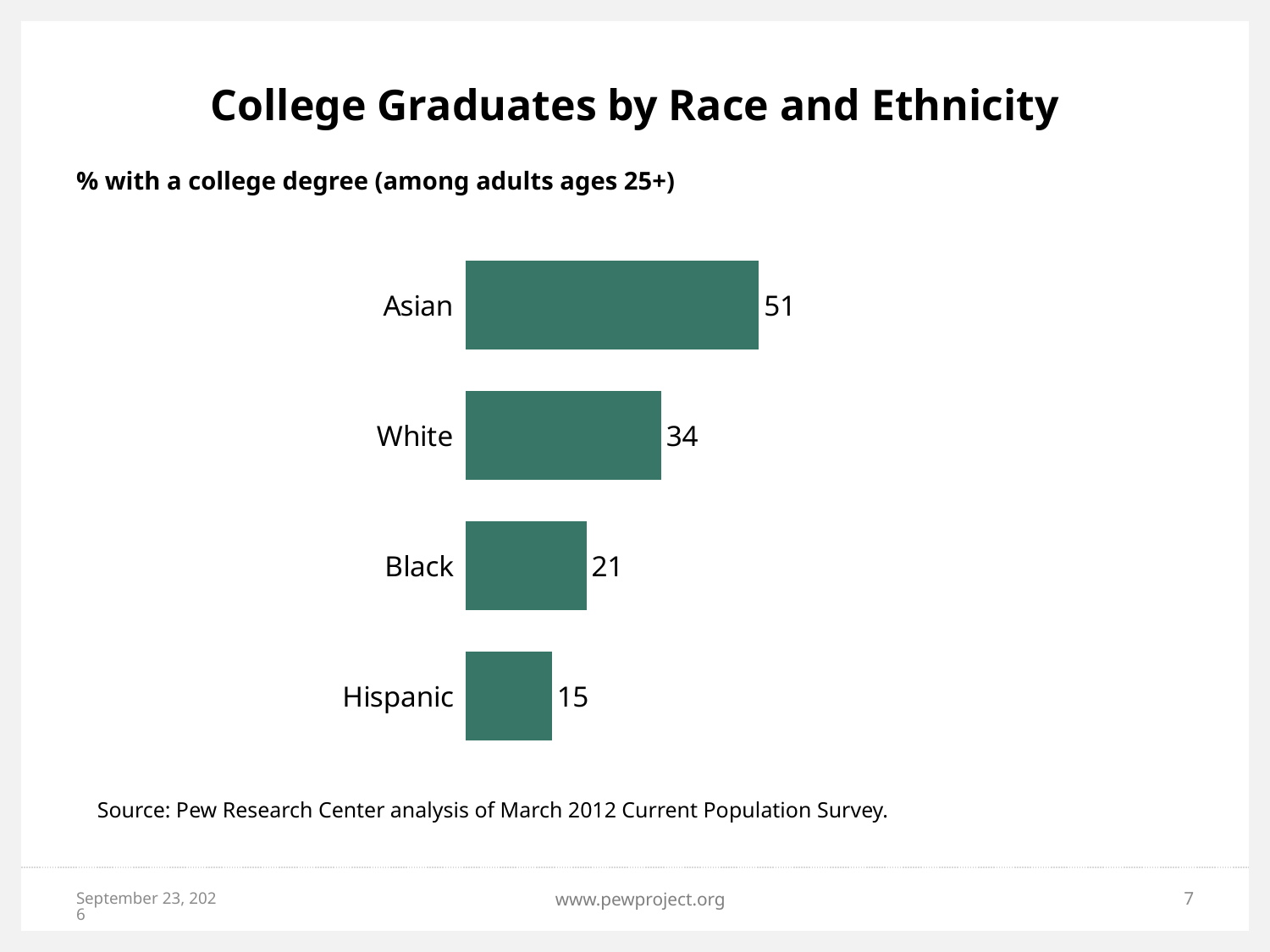
What is the value for Hispanic? 15 Which category has the highest value? Asian What is the difference between the values for Asian and White? 17 What is the value for White? 34 What is the value for Asian? 51 Which is larger, the value for White or the value for Black? White What kind of chart is shown on the slide? Bar chart What is the difference between the values for Black and Hispanic? 6 What is the title of the chart? College Graduates by Race and Ethnicity What is the value for Black? 21 How many categories are shown in the chart? 4 Which category has the lowest value? Hispanic